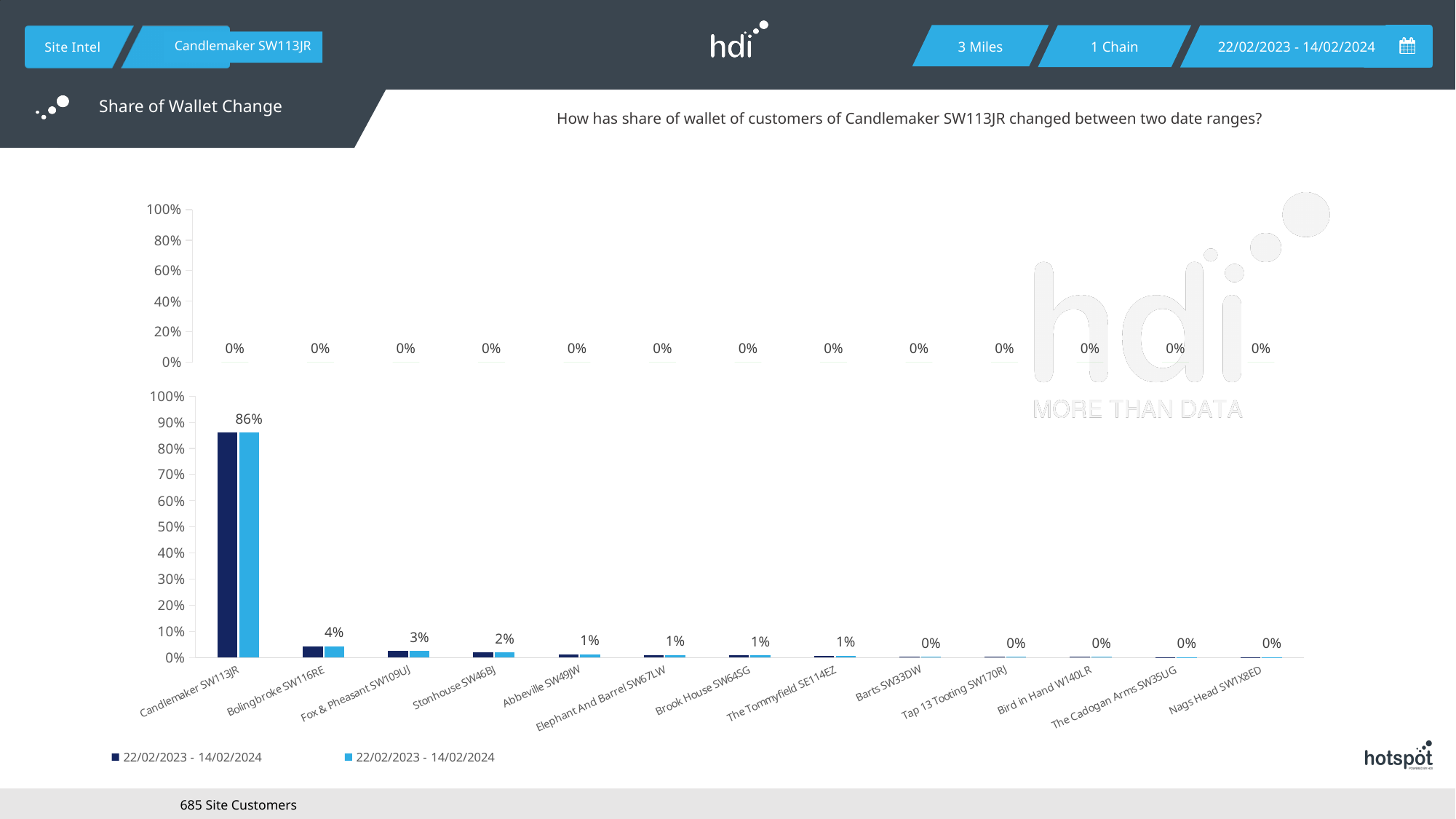
In the bottom chart, what value is labelled for Stonhouse SW46BJ? 2% In the bottom chart, what is the difference between the labelled values for Candlemaker SW113JR and Bolingbroke SW116RE? 82% How many series does the legend below the bottom chart list? 2 In the bottom chart, what value is labelled for Fox & Pheasant SW109UJ? 3% How many categories are shown on the x axis of the bottom chart? 13 In the bottom chart, which category has the highest value? Candlemaker SW113JR In the bottom chart, what is the share of wallet value shown for Candlemaker SW113JR? 86% In the bottom chart, is the value for Candlemaker SW113JR greater or less than 50%? greater What kind of chart is the bottom chart? bar chart In the top chart, what value is labelled for every category? 0% In the bottom chart, which has the larger labelled value, Fox & Pheasant SW109UJ or Stonhouse SW46BJ? Fox & Pheasant SW109UJ In the bottom chart, what value is labelled for Bolingbroke SW116RE? 4%